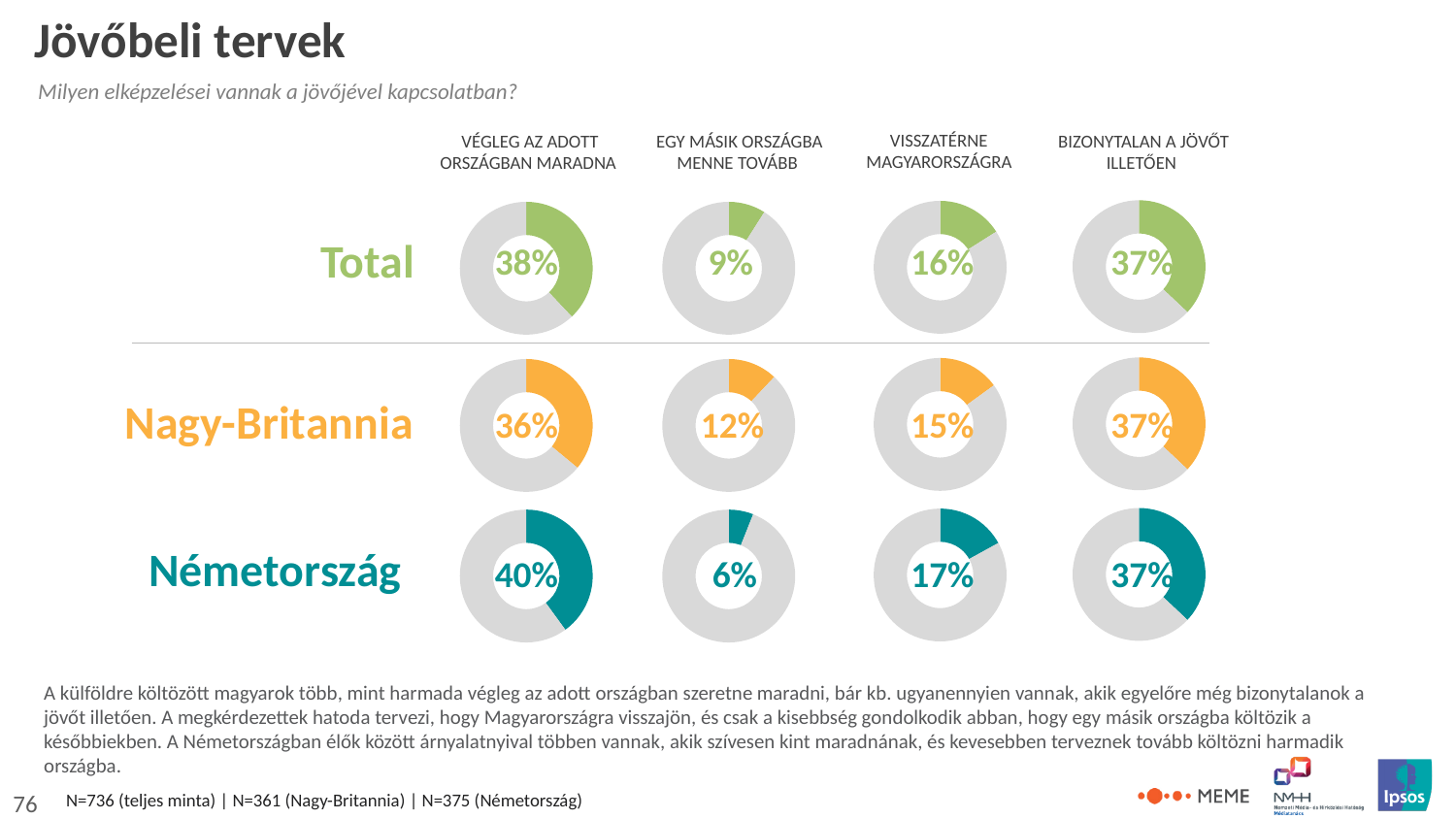
In the donut chart for Nagy-Britannia under "Egy másik országba menne tovább", what percentage is shown? 12% In the donut chart for Németország under "Visszatérne Magyarországra", what percentage is shown? 17% In the "Visszatérne Magyarországra" column, which is larger: the Total percentage or the Nagy-Britannia percentage? Total What is the difference between the Németország and Nagy-Britannia percentages in the "Végleg az adott országban maradna" column? 4% What is the difference between the Nagy-Britannia and Németország percentages in the "Egy másik országba menne tovább" column? 6% How many donut charts are shown on the slide? 12 What colour is used for the Németország row of donut charts? Teal In the donut chart for Németország under "Bizonytalan a jövőt illetően", what percentage is shown? 37% In the donut chart for Total under "Végleg az adott országban maradna", what percentage is shown? 38% Across the three donut charts in the "Egy másik országba menne tovább" column, which row has the lowest percentage? Németország Across the three donut charts in the "Végleg az adott országban maradna" column, which row has the highest percentage? Németország What type of chart is used to display the percentages on this slide? Donut (pie) chart